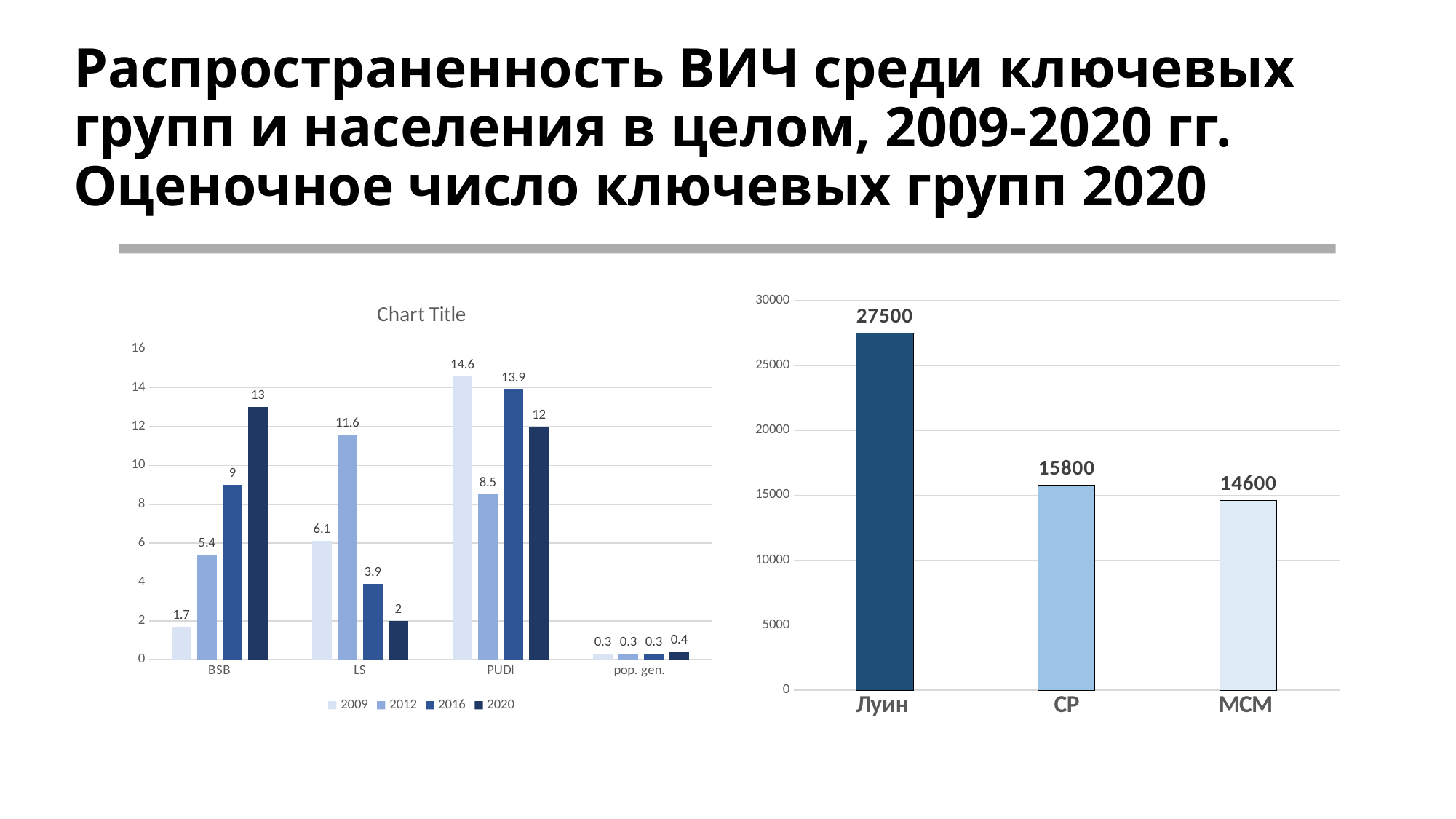
What kind of chart is the right chart? bar chart In the left chart titled "Chart Title", which category has the highest value in 2020? BSB In the left chart titled "Chart Title", how many series does the legend list? 4 In the left chart titled "Chart Title", which is larger for PUDI: the 2016 value or the 2020 value? 2016 In the right chart, what is the value for СР? 15800 In the right chart, what is the difference between the values for Луин and МСМ? 12900 In the left chart titled "Chart Title", do the values for BSB rise or fall from 2009 to 2020? rise In the left chart titled "Chart Title", what is the difference between the 2012 and 2020 values for LS? 9.6 In the left chart titled "Chart Title", what is the value for BSB in 2020? 13 In the left chart titled "Chart Title", what is the value for PUDI in 2009? 14.6 In the left chart titled "Chart Title", which category has the lowest value in 2009? pop. gen. In the left chart titled "Chart Title", what is the value for LS in 2012? 11.6